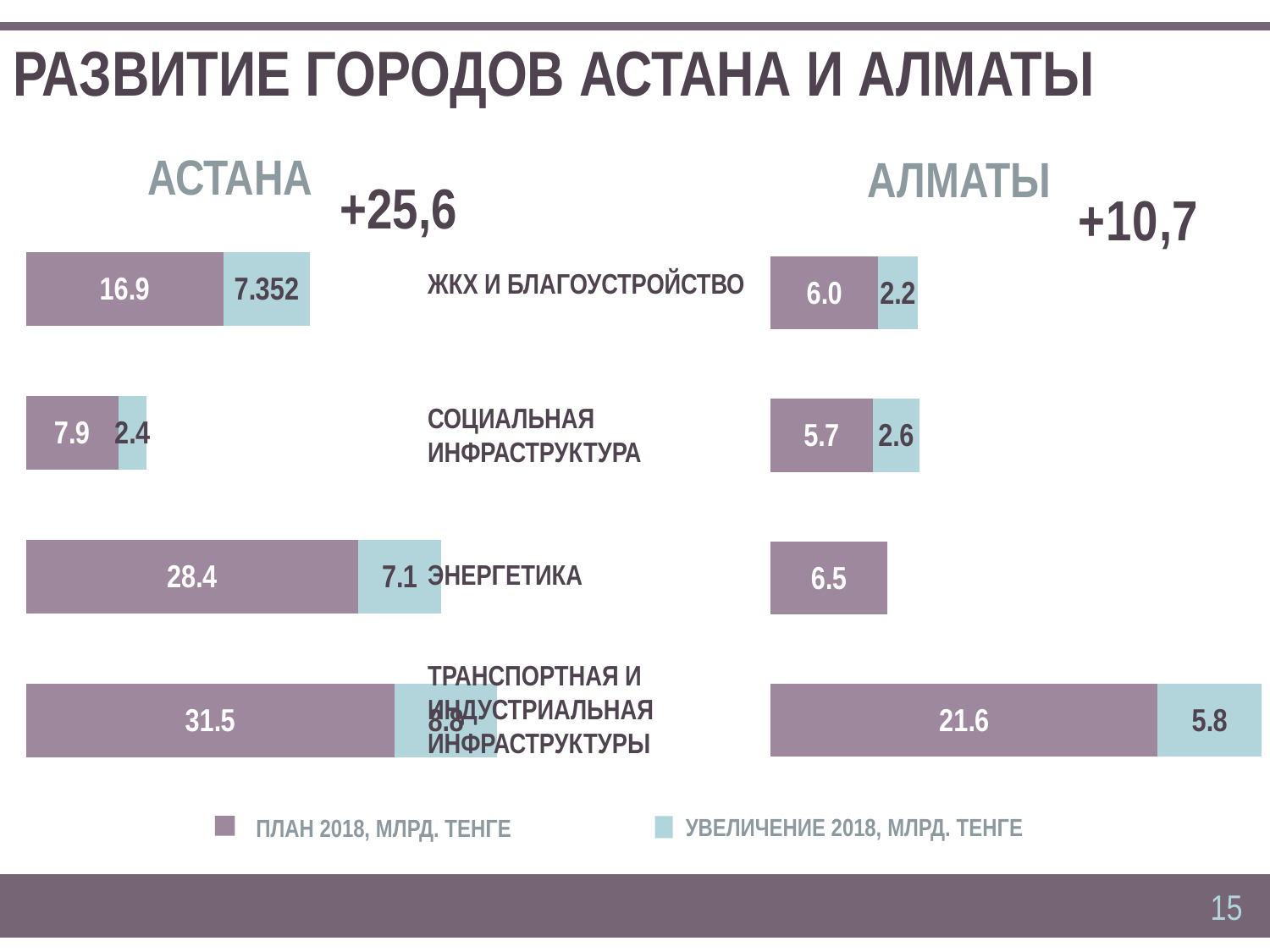
On the Астана chart, what is the План 2018 value for ЖКХ и благоустройство? 16.9 How many series does the legend list? 2 What kind of chart is used for Астана and Алматы on this slide? Stacked bar chart On the Астана chart, how much larger is the План 2018 value for Энергетика than for ЖКХ и благоустройство? 11.5 On the Алматы chart, what is the План 2018 value for Транспортная и индустриальная инфраструктуры? 21.6 On the Алматы chart, which has the larger План 2018 value: ЖКХ и благоустройство or Энергетика? Энергетика On the Алматы chart, which category has the highest План 2018 value? Транспортная и индустриальная инфраструктуры On the Астана chart, which category has the lowest План 2018 value? Социальная инфраструктура On the Алматы chart, what is the Увеличение 2018 value for Социальная инфраструктура? 2.6 On the Астана chart, what is the Увеличение 2018 value for Энергетика? 7.1 On the Алматы chart, what is the total of the stacked bar for ЖКХ и благоустройство? 8.2 What total increase figure is shown above the Астана chart? +25,6